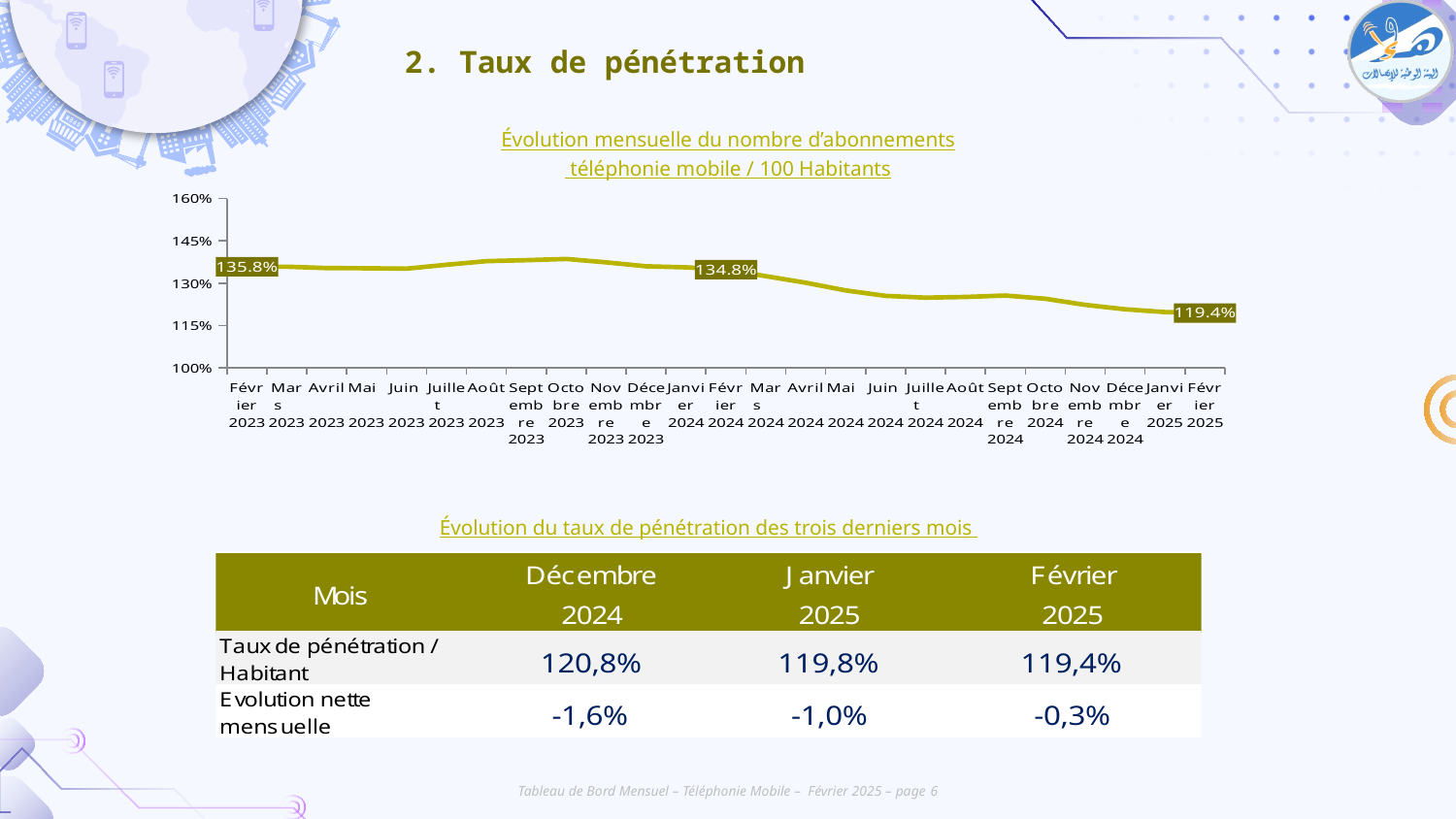
Is the value for Février 2025 greater or less than 130%? less What kind of chart is shown on the slide? line chart Which month has the lowest value on the line chart? Février 2025 Which is larger, the value for Février 2023 or the value for Février 2025? Février 2023 Do the values on the chart generally rise or fall from Février 2023 to Février 2025? fall How many months are plotted on the x axis of the chart? 25 What is the value for Février 2025 on the line chart? 119.4% What is the value for Février 2023 on the line chart? 135.8% What is the difference between the labelled values for Février 2023 and Février 2025? 16.4 percentage points Is the value for Février 2023 greater or less than 130%? greater